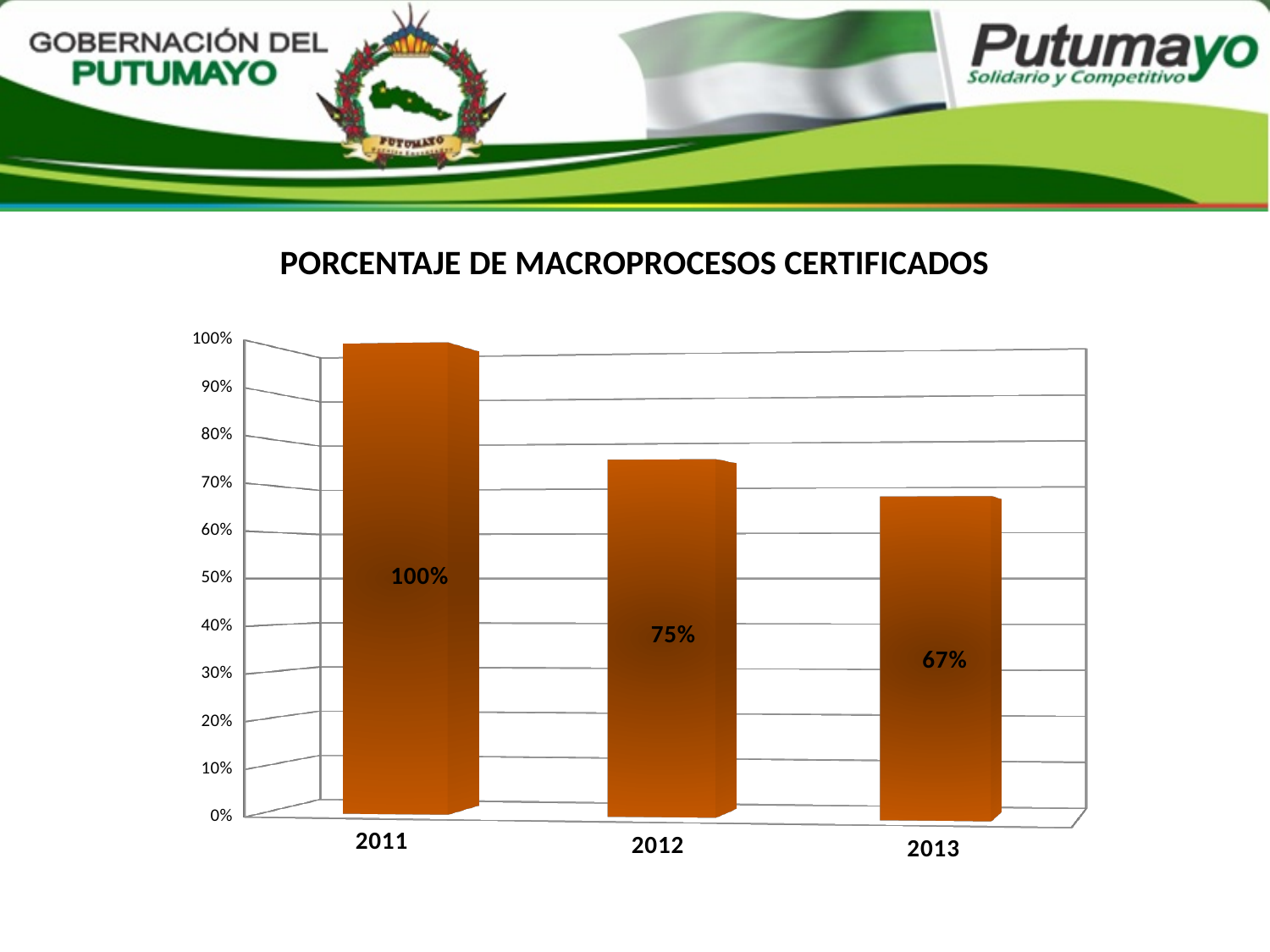
What is the value for 2013? 67% What kind of chart is shown on the slide? bar chart Which is larger, the value for 2012 or the value for 2013? 2012 What is the difference between the values for 2012 and 2013? 8% What is the difference between the values for 2011 and 2013? 33% Do the values rise or fall from 2011 to 2013? fall How many years are shown on the chart? 3 What is the value for 2011? 100% What is the value for 2012? 75% Is the value for 2013 greater or less than 70%? less Which year has the highest percentage of certified macroprocesses? 2011 Which year has the lowest percentage of certified macroprocesses? 2013